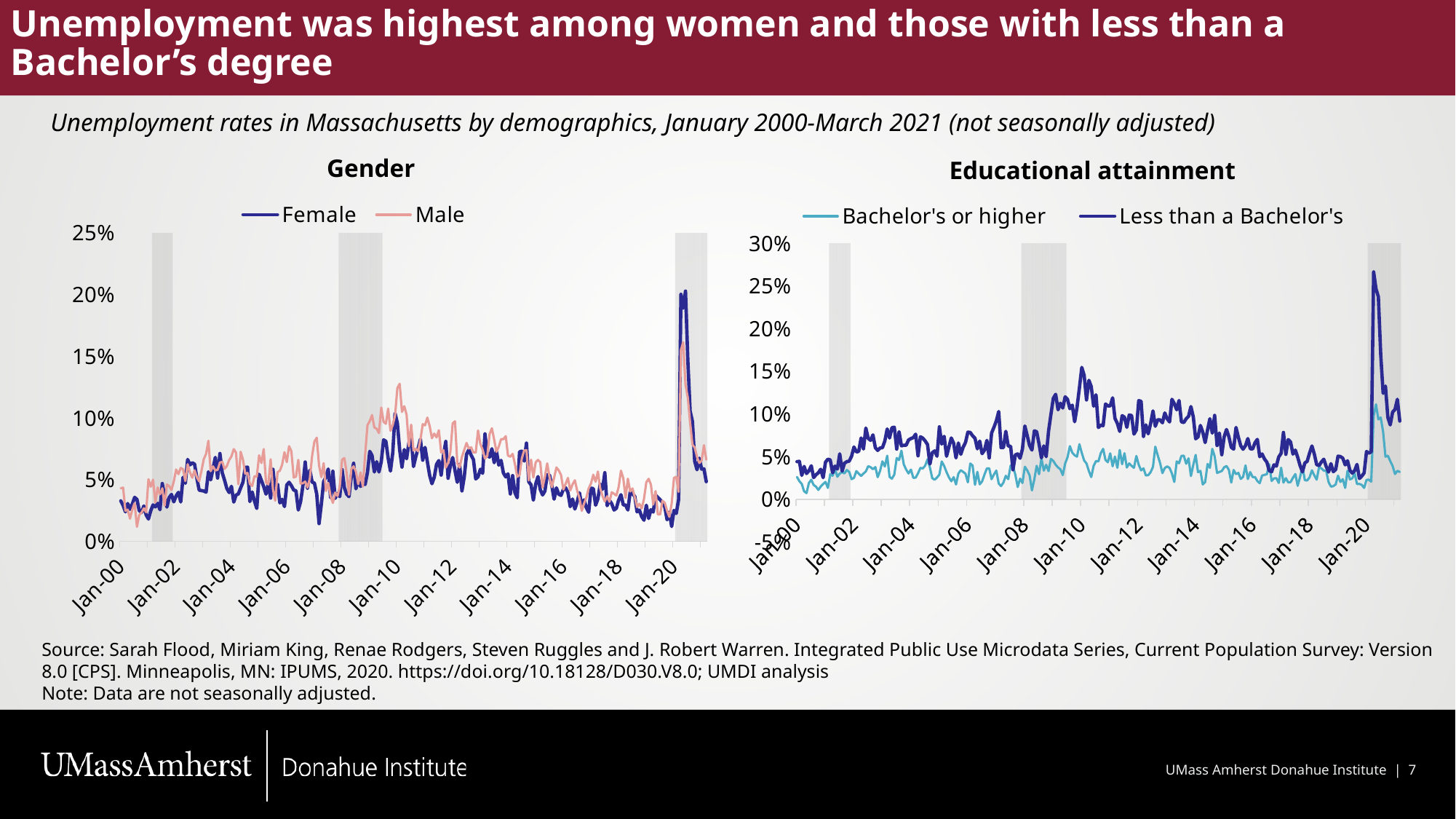
What are the two series listed in the legend of the Gender chart? Female and Male In the Gender chart, which series reaches the higher peak around 2020, Female or Male? Female What is the highest value shown on the y axis of the Educational attainment chart? 30% In the Educational attainment chart, is the peak value for Less than a Bachelor's around 2020 greater or less than 25%? greater What kind of chart is the Gender chart? line chart In the Educational attainment chart, does the Less than a Bachelor's line generally rise or fall between Jan-10 and Jan-18? fall In the Gender chart, does the Male line generally rise or fall between Jan-10 and Jan-18? fall In the Educational attainment chart, which series reaches the higher peak around 2020? Less than a Bachelor's How many series does the legend of the Educational attainment chart list? 2 In the Educational attainment chart, is the peak value for Bachelor's or higher around 2020 greater or less than 15%? less In the Gender chart, is the peak value for Female around 2020 greater or less than 25%? less